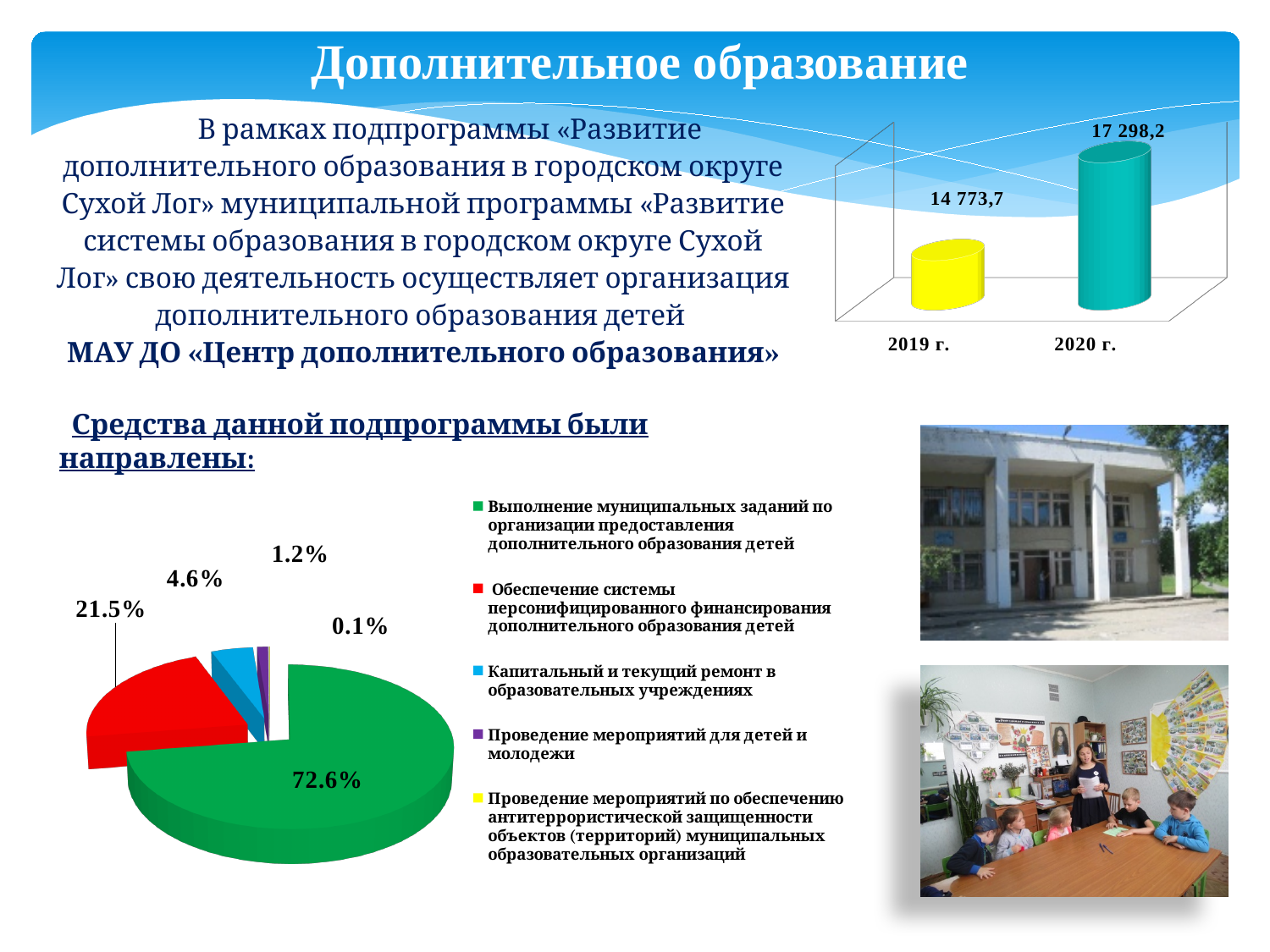
In the bar chart at the top right of the slide, what is the difference between the 2020 г. and 2019 г. values? 2 524,5 In the pie chart at the bottom left of the slide, what is the smallest share shown? 0.1% What type of chart is shown at the top right of the slide? Bar chart In the pie chart at the bottom left of the slide, which category has the largest share? Выполнение муниципальных заданий по организации предоставления дополнительного образования детей In the pie chart at the bottom left of the slide, what is the share for Обеспечение системы персонифицированного финансирования дополнительного образования детей? 21.5% In the bar chart at the top right of the slide, which year has the higher value? 2020 г. How many entries does the legend of the pie chart at the bottom left of the slide list? 5 In the bar chart at the top right of the slide, what is the value for 2019 г.? 14 773,7 In the bar chart at the top right of the slide, how many bars are shown? 2 In the bar chart at the top right of the slide, what is the value for 2020 г.? 17 298,2 In the pie chart at the bottom left of the slide, what share does the largest slice have? 72.6% In the bar chart at the top right of the slide, do the values rise or fall from 2019 г. to 2020 г.? Rise